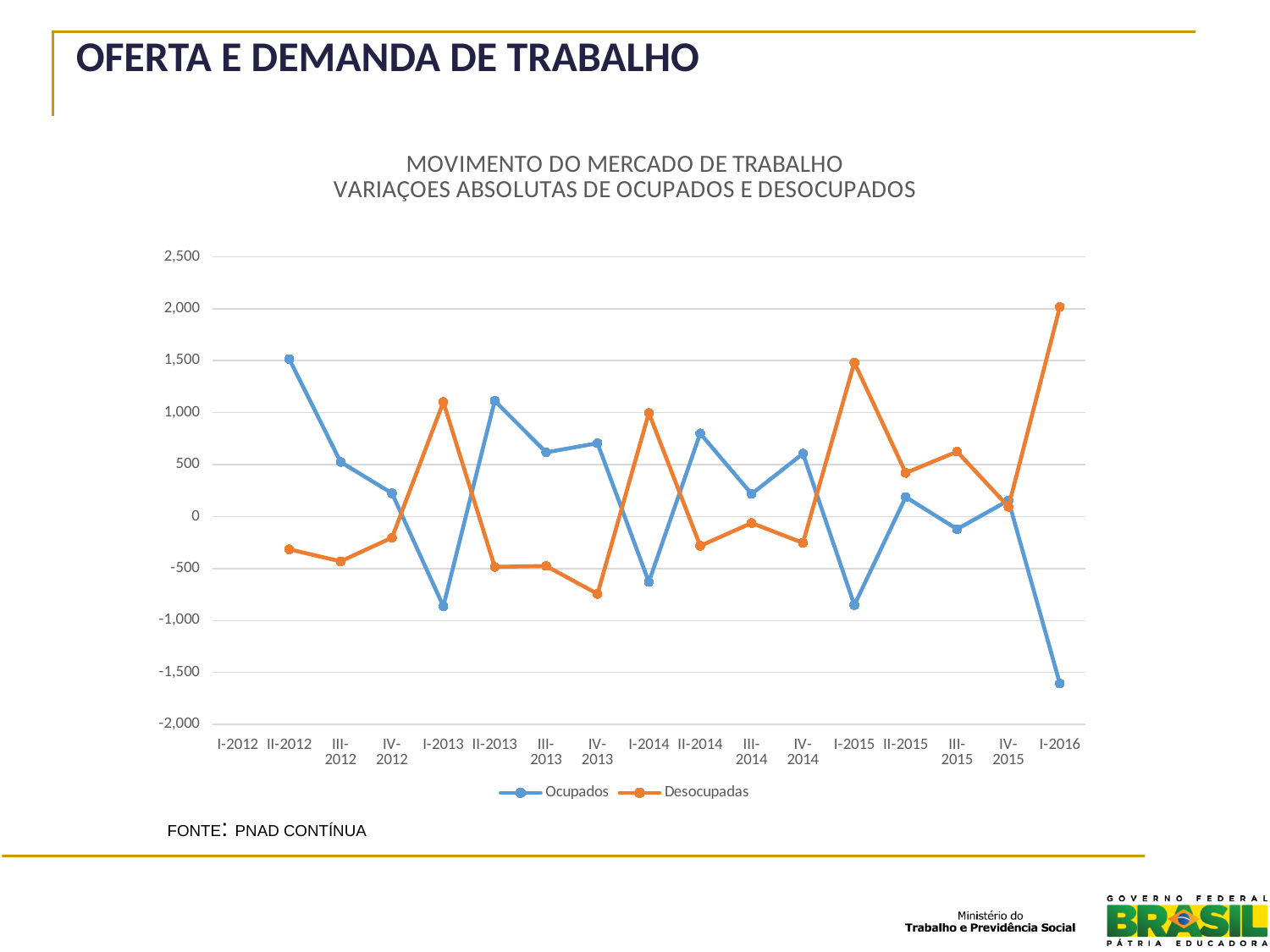
In which period does the Desocupadas series reach its highest value? I-2016 How many series does the legend list? 2 In which period does the Desocupadas series reach its lowest value? IV-2013 What kind of chart is shown on the slide? line chart Is the value for Desocupadas in I-2016 greater or less than 1,500? greater In I-2015, which series has the larger value, Ocupados or Desocupadas? Desocupadas How many category labels are shown on the x axis? 17 Does the Ocupados series rise or fall from IV-2015 to I-2016? fall Is the value for Ocupados in I-2016 greater or less than -1,000? less What are the two series named in the legend? Ocupados and Desocupadas In which period does the Ocupados series reach its highest value? II-2012 In which period does the Ocupados series reach its lowest value? I-2016